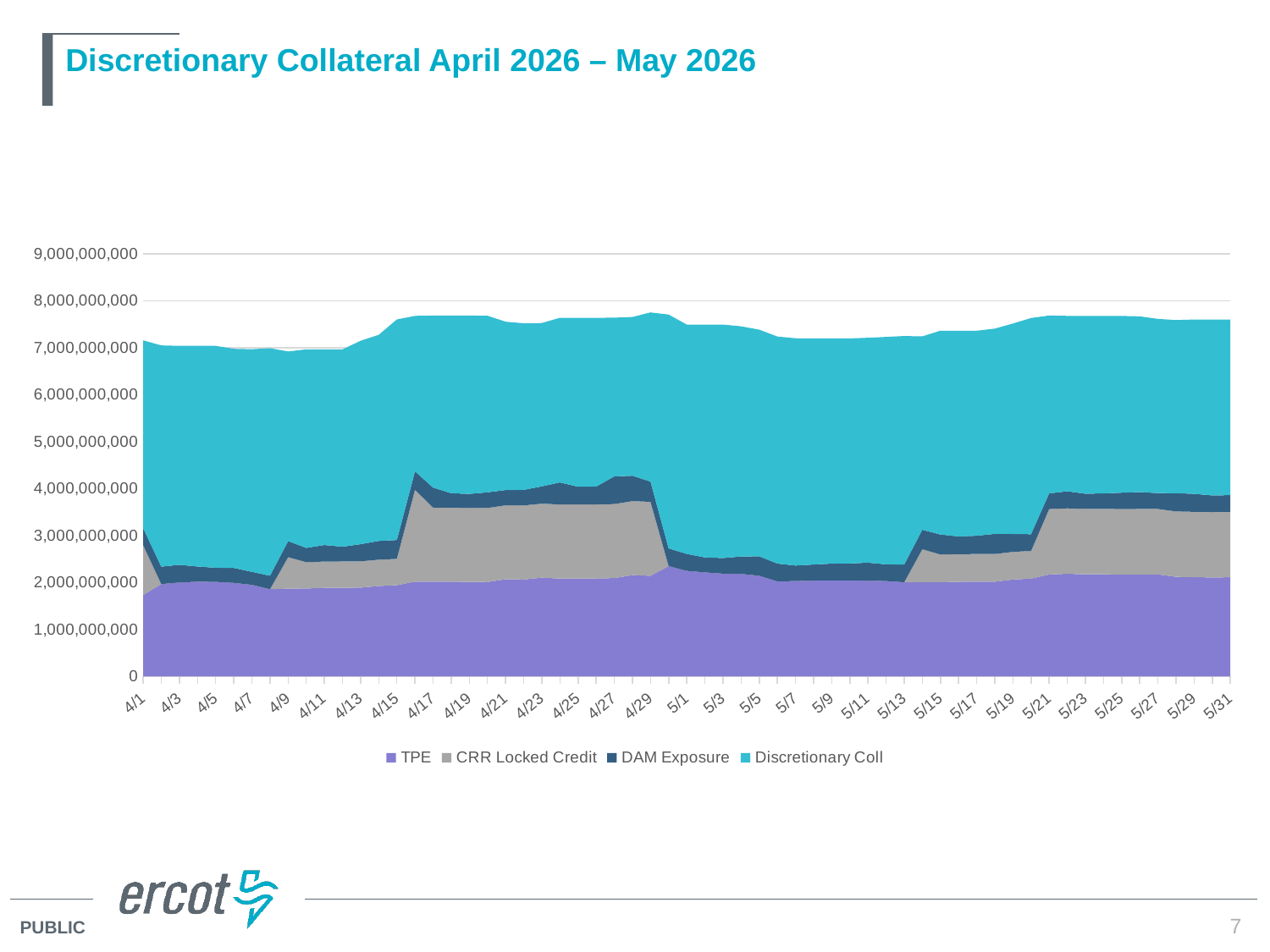
Which series occupies the largest share of the stacked area across the period, Discretionary Coll or DAM Exposure? Discretionary Coll What is the highest value shown on the vertical axis? 9,000,000,000 Is the value for TPE on 4/1 greater or less than 2,000,000,000? less Is the total stacked value on 5/31 greater or less than 7,000,000,000? greater What kind of chart is shown on the slide? Stacked area chart Which series is plotted as the bottom layer of the stacked area chart? TPE What is the title of the chart on the slide? Discretionary Collateral April 2026 – May 2026 Is the total stacked value on 5/21 greater or less than 7,000,000,000? greater How many series does the legend list? 4 Does the total stacked value rise or fall from 4/13 to 4/17? rise